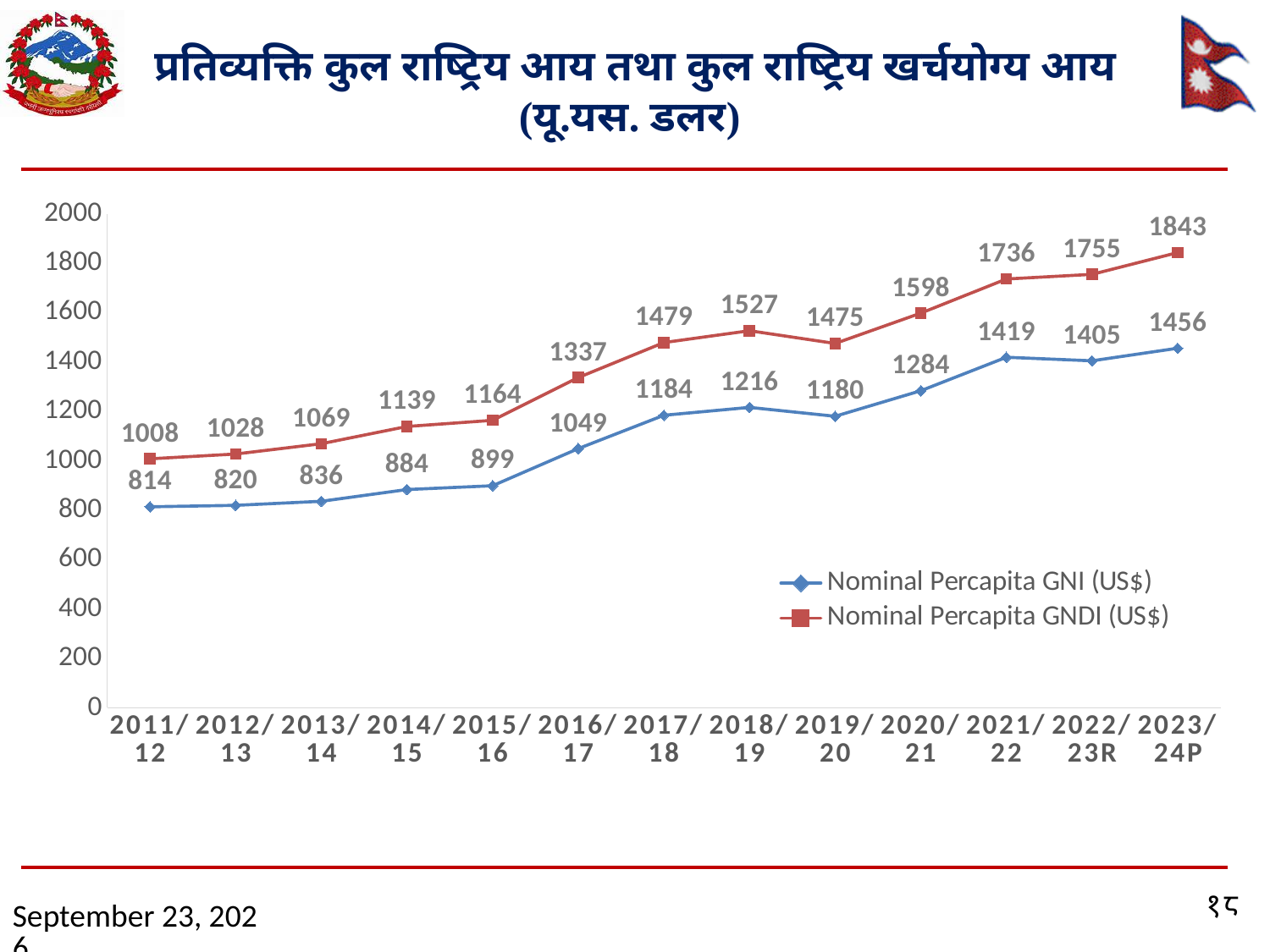
What kind of chart is shown on the slide? line chart What is the difference between Nominal Percapita GNDI (US$) and Nominal Percapita GNI (US$) in 2023/24P? 387 Does the Nominal Percapita GNDI (US$) series rise or fall from 2011/12 to 2023/24P overall? rise Which is larger in 2019/20: Nominal Percapita GNI (US$) or Nominal Percapita GNDI (US$)? Nominal Percapita GNDI (US$) What is the Nominal Percapita GNI (US$) value for 2011/12? 814 How many series does the legend list? 2 How many years are shown on the x axis? 13 What is the Nominal Percapita GNI (US$) value for 2023/24P? 1456 In which year is the Nominal Percapita GNI (US$) lowest? 2011/12 Is the Nominal Percapita GNI (US$) value for 2016/17 greater or less than 1200? less In which year is the Nominal Percapita GNDI (US$) highest? 2023/24P What is the Nominal Percapita GNDI (US$) value for 2018/19? 1527